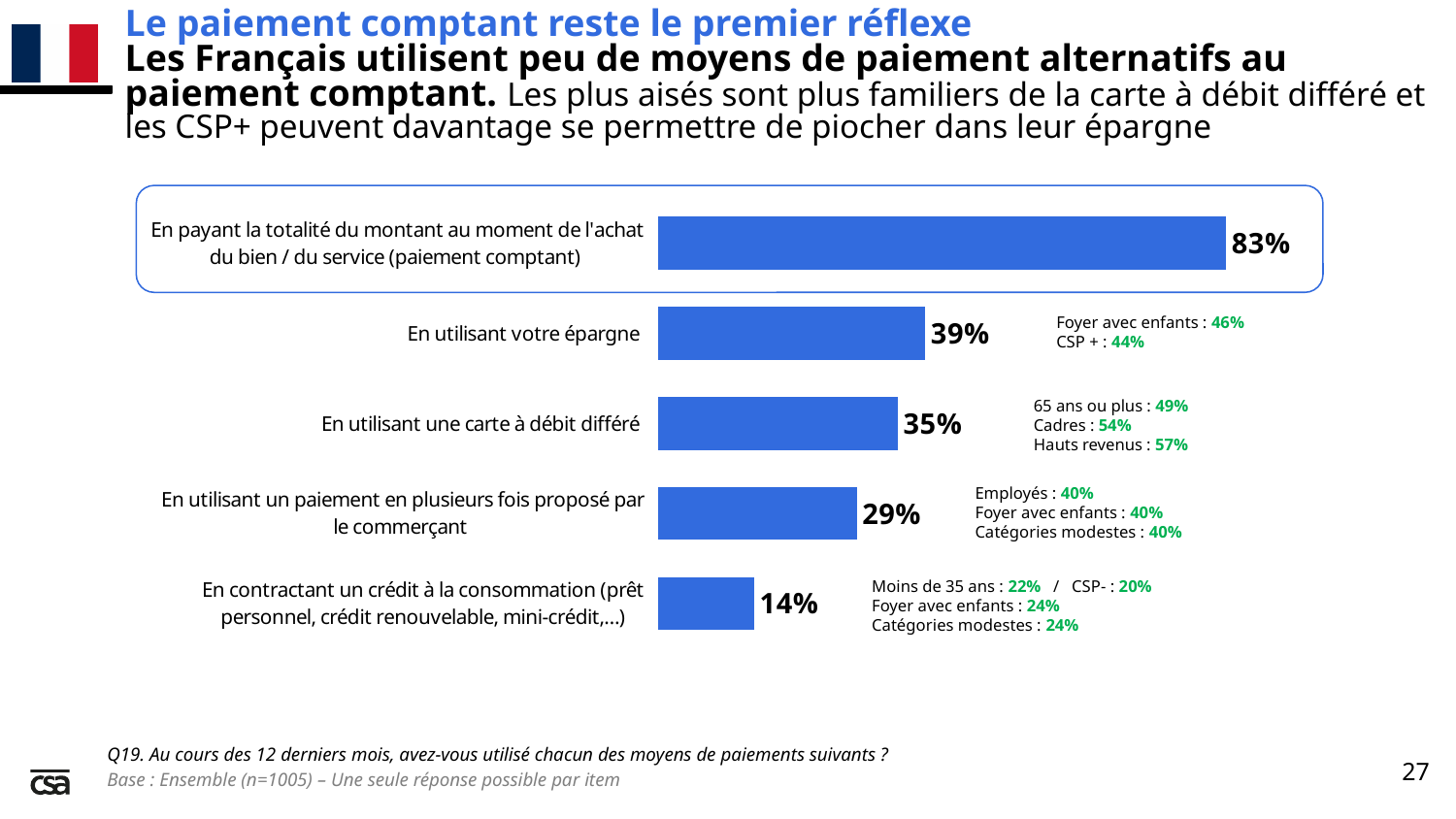
Which category has the lowest value? En contractant un crédit à la consommation (prêt personnel, crédit renouvelable, mini-crédit,...) What is the value shown for "Hauts revenus" next to the "En utilisant une carte à débit différé" bar? 57% What is the value for "En contractant un crédit à la consommation (prêt personnel, crédit renouvelable, mini-crédit,...)"? 14% What is the value for "En payant la totalité du montant au moment de l'achat du bien / du service (paiement comptant)"? 83% What kind of chart is shown on the slide? Bar chart How many categories are shown in the chart? 5 What is the value for "En utilisant votre épargne"? 39% What is the value for "En utilisant une carte à débit différé"? 35% What is the difference between the value for paiement comptant and the value for "En utilisant un paiement en plusieurs fois proposé par le commerçant"? 54% What is the difference between the value for "En utilisant votre épargne" and the value for "En utilisant une carte à débit différé"? 4% Which category has the highest value? En payant la totalité du montant au moment de l'achat du bien / du service (paiement comptant) Which is larger: the value for "En utilisant un paiement en plusieurs fois proposé par le commerçant" or the value for "En contractant un crédit à la consommation"? En utilisant un paiement en plusieurs fois proposé par le commerçant